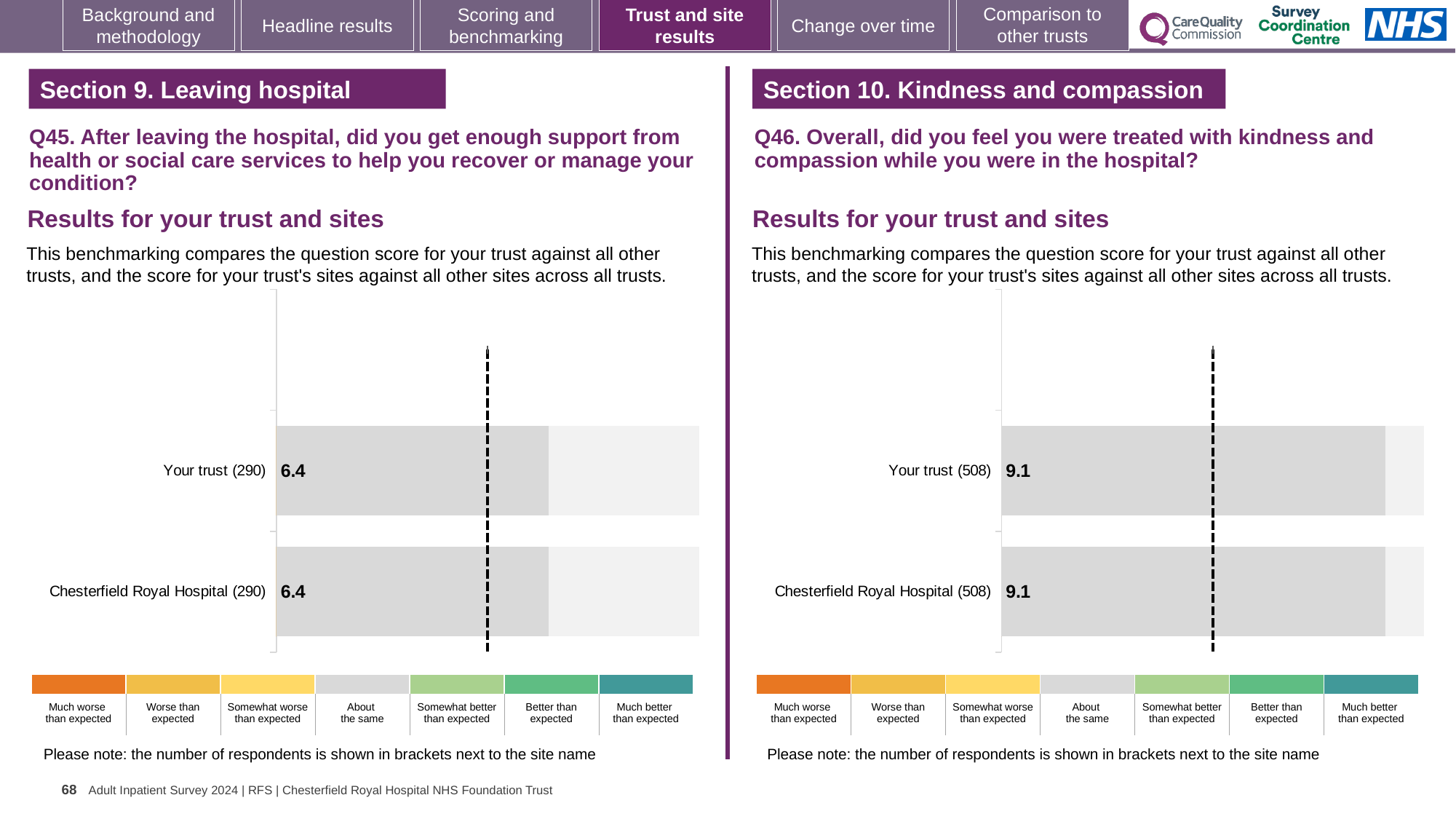
In the Q46 chart on the right, is the score for Your trust larger than, smaller than, or the same as the score for Chesterfield Royal Hospital? the same What kind of chart is used for the Q46 results on the right? bar chart How many bars are plotted in the Q45 chart on the left? 2 In the Q46 chart on the right, what is the score for Your trust? 9.1 In the Q45 chart on the left, what is the score for Chesterfield Royal Hospital? 6.4 In the Q45 chart on the left, how many respondents are shown in brackets next to Your trust? 290 In the Q46 chart on the right, how many respondents are shown in brackets next to Chesterfield Royal Hospital? 508 How many categories does the colour key below the Q45 chart on the left list? 7 In the Q45 chart on the left, what is the score for Your trust? 6.4 How many bars are plotted in the Q46 chart on the right? 2 In the Q45 chart on the left, what is the difference between the score for Your trust and the score for Chesterfield Royal Hospital? 0 In the Q46 chart on the right, what is the score for Chesterfield Royal Hospital? 9.1